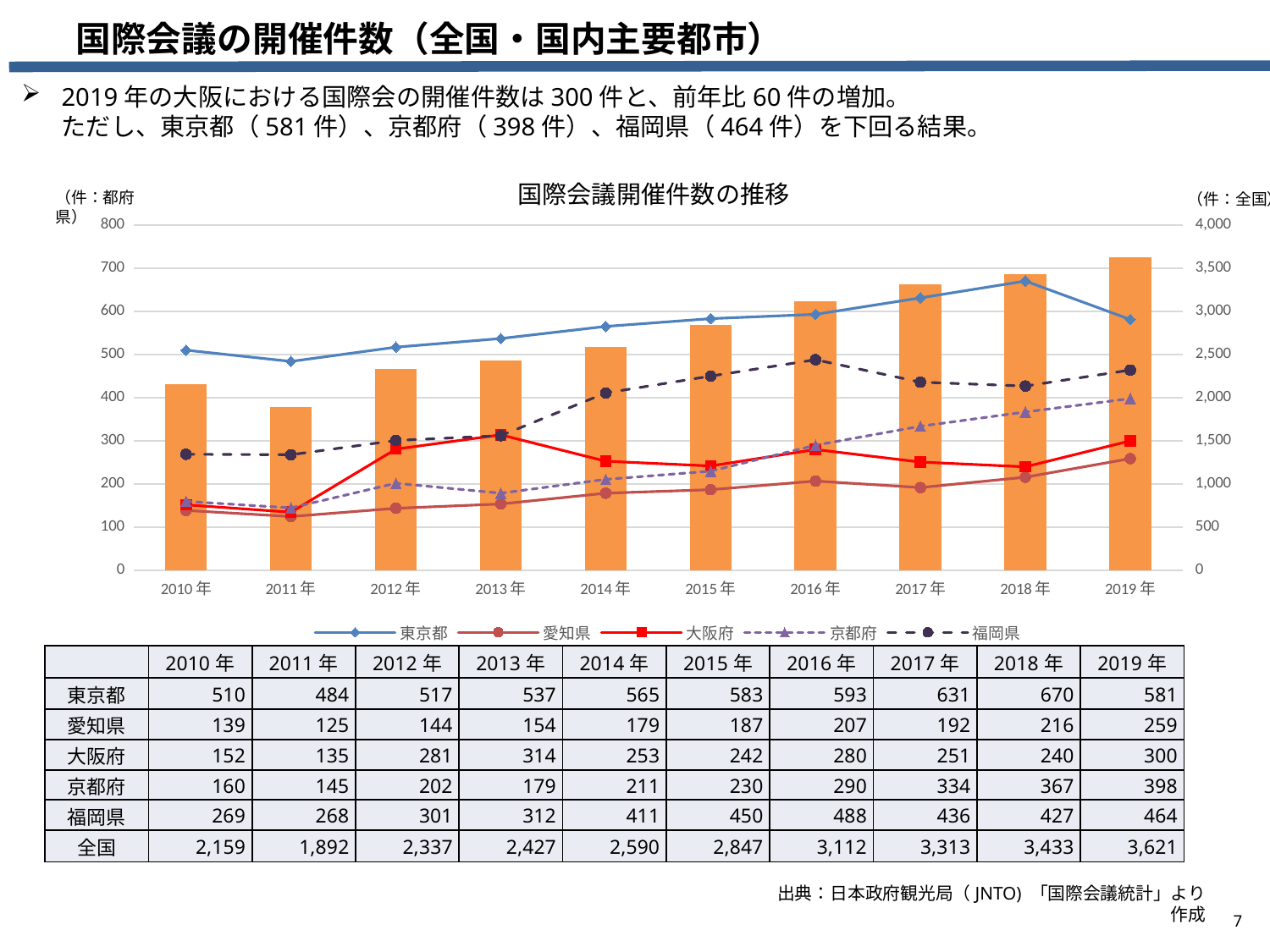
In the chart 国際会議開催件数の推移, how many years are shown on the x axis? 10 What is the title of the chart on the slide? 国際会議開催件数の推移 In the chart 国際会議開催件数の推移, what is the difference between the 大阪府 values for 2019年 and 2018年? 60 In the chart 国際会議開催件数の推移, what is the value for 福岡県 in 2016年? 488 In the chart 国際会議開催件数の推移, which is larger in 2019年: 京都府 or 福岡県? 福岡県 In the chart 国際会議開催件数の推移, what is the value for 東京都 in 2019年? 581 In the chart 国際会議開催件数の推移, how many series does the legend list? 5 In the chart 国際会議開催件数の推移, in which year is the value for 全国 lowest? 2011年 In the chart 国際会議開催件数の推移, what is the value for 全国 in 2019年? 3,621 In the chart 国際会議開催件数の推移, in which year is the value for 東京都 highest? 2018年 In the chart 国際会議開催件数の推移, do the 全国 bars generally rise or fall from 2010年 to 2019年? Rise What kind of chart is 国際会議開催件数の推移? Combined bar and line chart